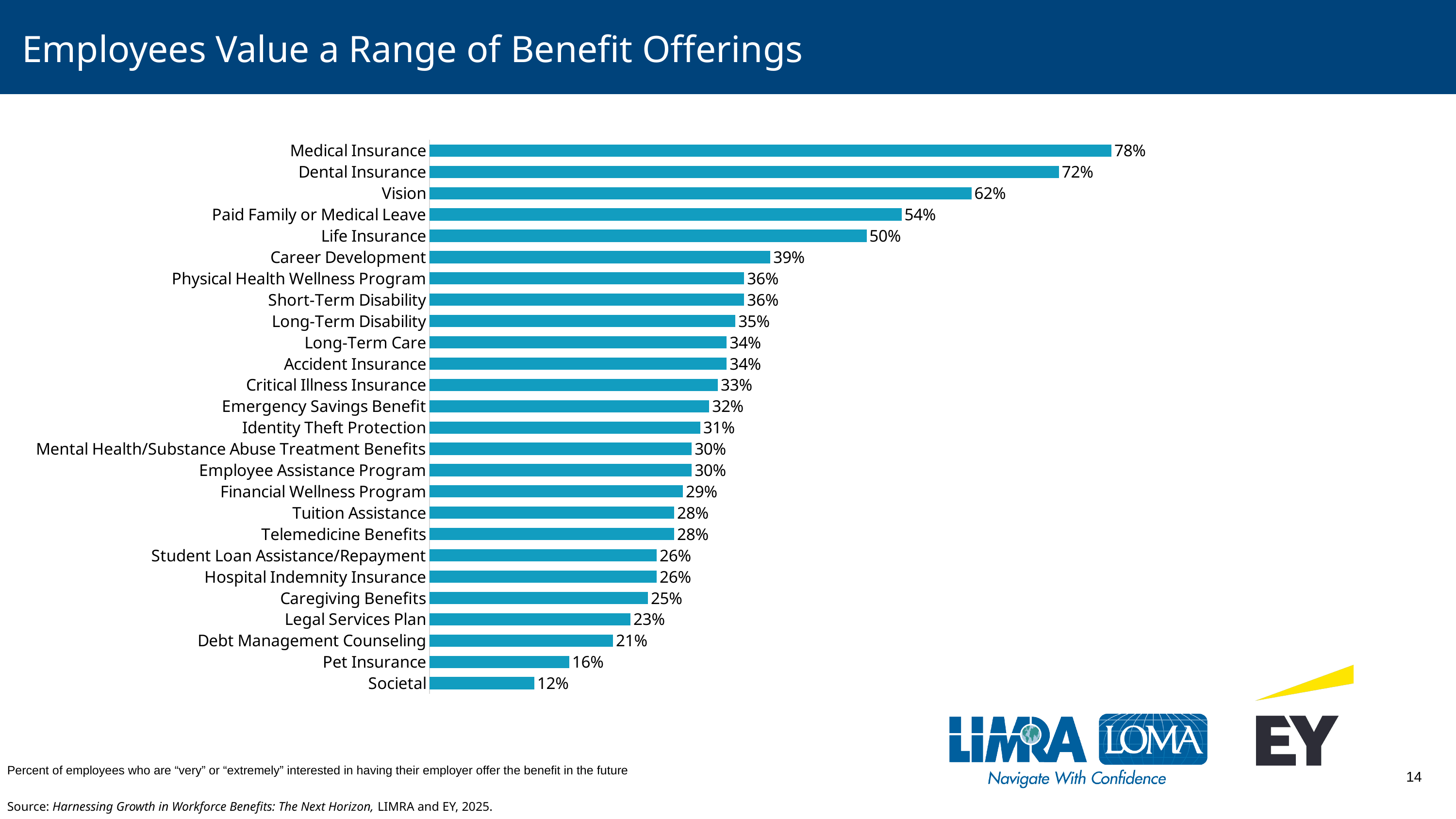
Which benefit has the highest percentage of interested employees? Medical Insurance What is the difference in percentage points between Medical Insurance and Dental Insurance? 6 What is the value shown for Pet Insurance? 16% What is the value shown for Paid Family or Medical Leave? 54% Which benefit has the lowest percentage of interested employees? Societal Which has a higher value, Vision or Life Insurance? Vision What type of chart is shown on the slide? Bar chart How many benefit categories are shown in the chart? 26 Which has a higher value, Legal Services Plan or Caregiving Benefits? Caregiving Benefits What is the value shown for Identity Theft Protection? 31% What is the difference in percentage points between Life Insurance and Career Development? 11 What percentage of employees are very or extremely interested in Medical Insurance? 78%